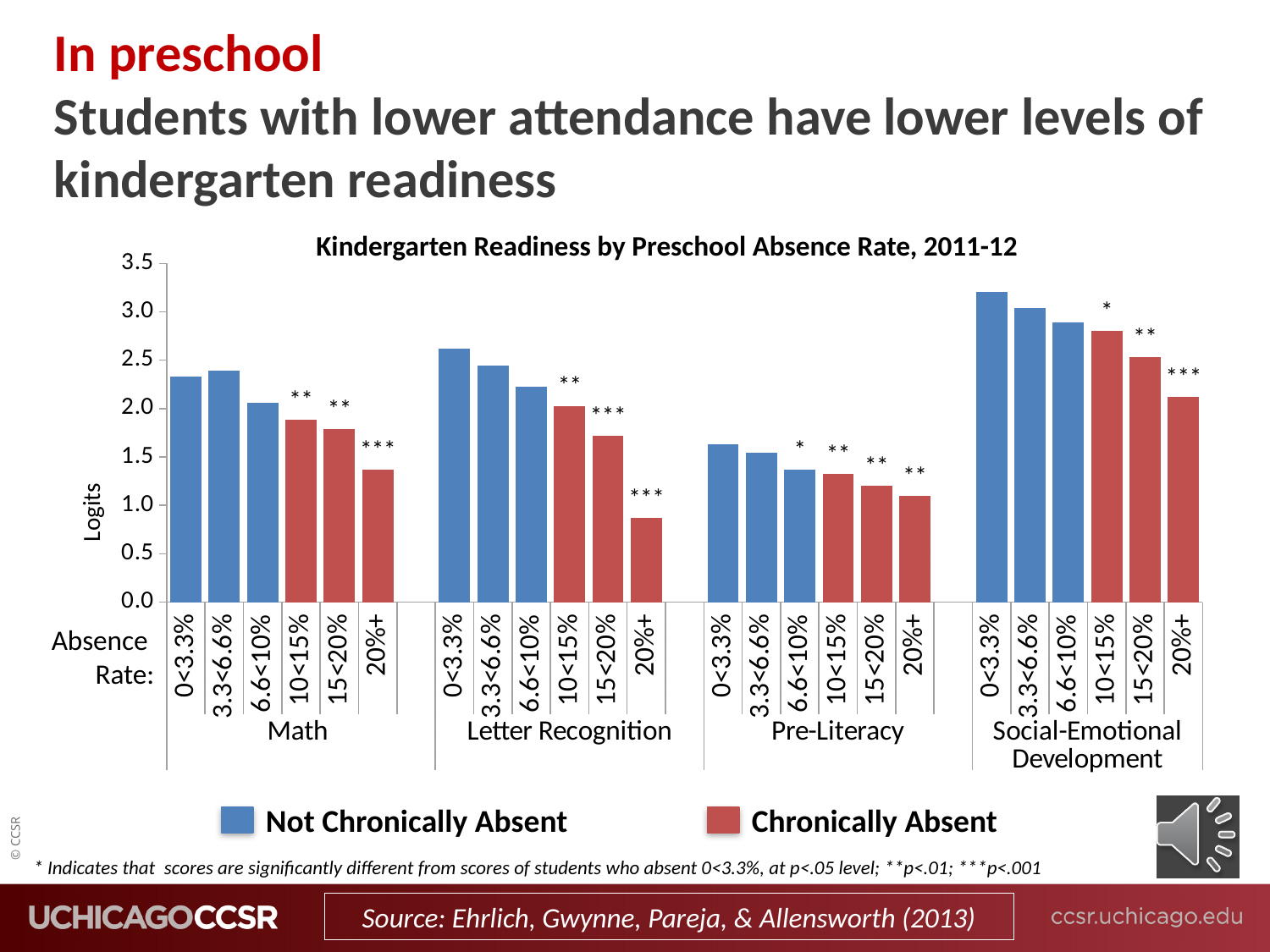
Within Pre-Literacy, do the values rise or fall as the absence rate increases from 0<3.3% to 20%+? fall Which outcome area and absence rate group has the lowest bar in the chart? Letter Recognition, 20%+ How many series does the legend list? 2 Which outcome area and absence rate group has the highest bar in the chart? Social-Emotional Development, 0<3.3% How many readiness outcome areas are shown along the x axis? 4 What kind of chart is shown on the slide? bar chart Is the value for the 20%+ absence group in Math greater or less than 1.5? less Which is larger: the 0<3.3% bar for Letter Recognition or the 0<3.3% bar for Math? Letter Recognition Is the value for the 20%+ absence group in Social-Emotional Development greater or less than 2.0? greater Is the value for the 0<3.3% absence group in Letter Recognition greater or less than 2.5? greater What are the two legend entries in the chart? Not Chronically Absent; Chronically Absent